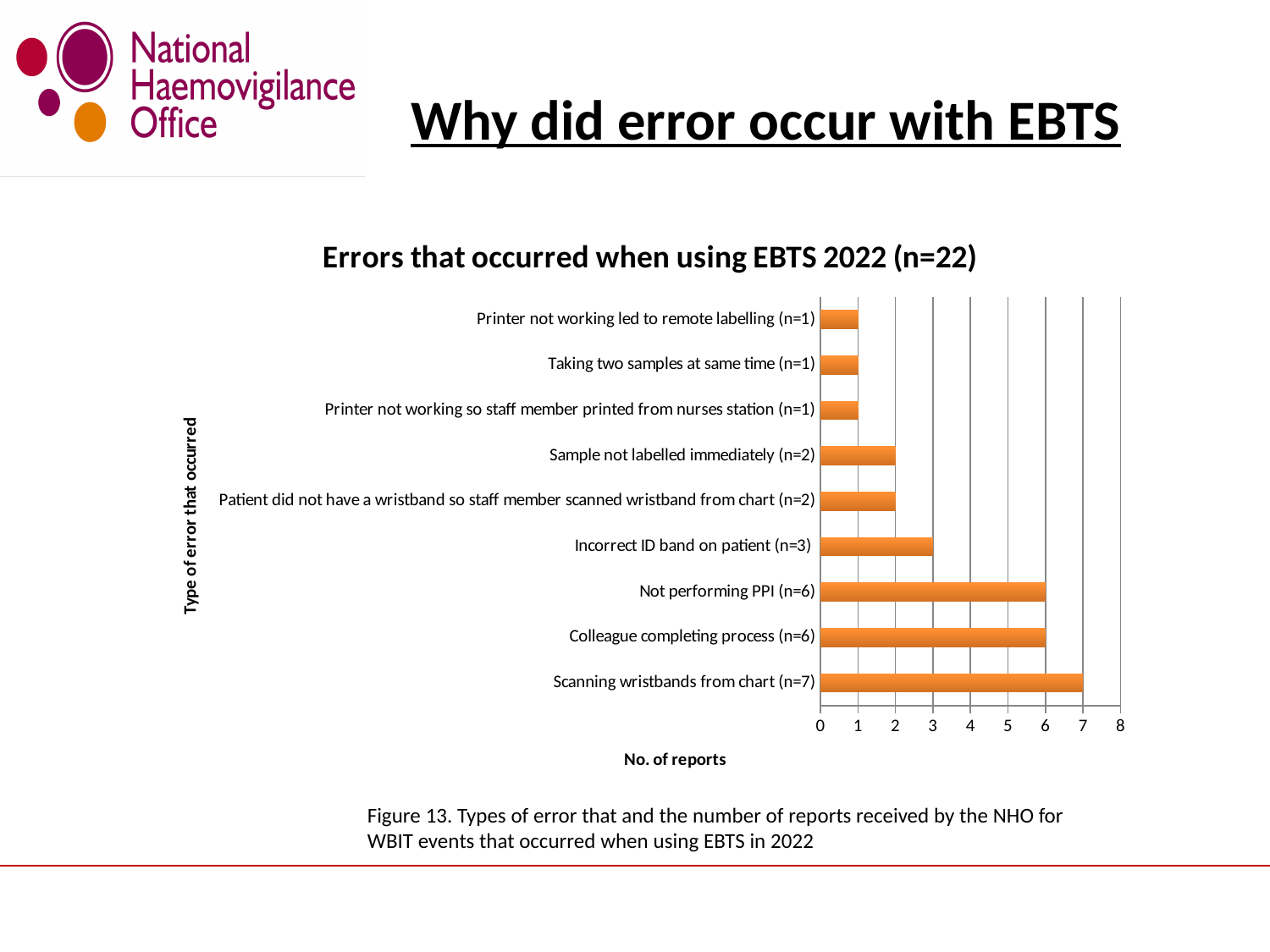
How many reports were received for 'Taking two samples at same time'? 1 What is the difference in the number of reports between 'Scanning wristbands from chart' and 'Incorrect ID band on patient'? 4 What is the label of the x axis? No. of reports What is the title of the chart? Errors that occurred when using EBTS 2022 (n=22) How many reports were received for 'Sample not labelled immediately'? 2 How many reports were received for 'Scanning wristbands from chart'? 7 Which has more reports: 'Not performing PPI' or 'Sample not labelled immediately'? Not performing PPI What type of chart is shown on the slide? Bar chart How many types of error are listed in the chart? 9 Which type of error has the highest number of reports? Scanning wristbands from chart Is the value for 'Colleague completing process' greater or less than 4? greater How many reports were received for 'Incorrect ID band on patient'? 3